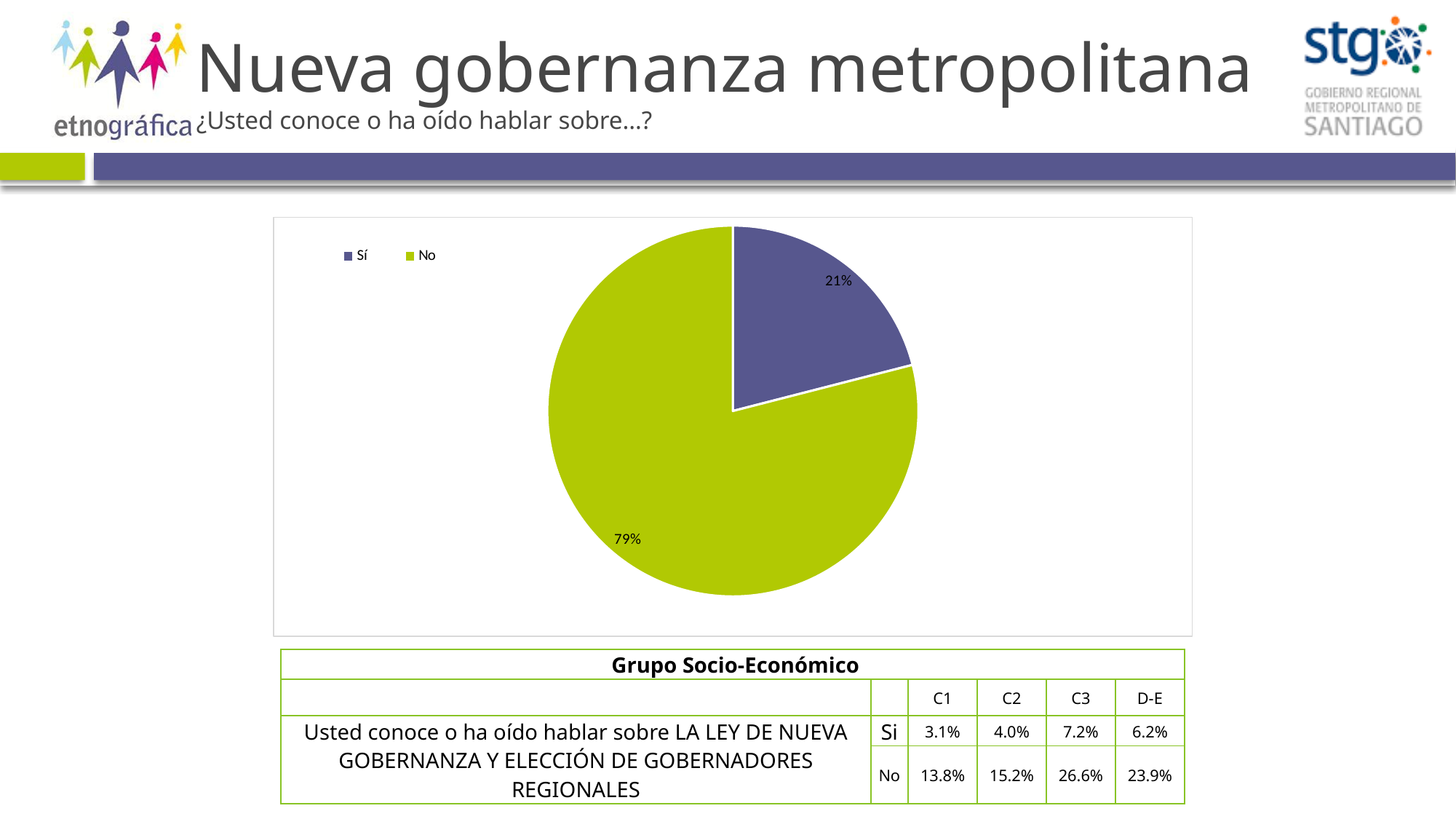
How many slices does the pie chart have? 2 What colour is the "No" slice in the pie chart? green What is the total of the two slices shown in the pie chart? 100% Which slice of the pie chart is the largest? No Which is larger in the pie chart, the "Sí" slice or the "No" slice? No What percentage of the pie chart is labelled "No"? 79% Which slice of the pie chart is the smallest? Sí What percentage of the pie chart is labelled "Sí"? 21% What colour is the "Sí" slice in the pie chart? purple How many entries does the legend of the pie chart list? 2 What kind of chart is shown on the slide? pie chart What is the difference in percentage points between the "No" slice and the "Sí" slice? 58